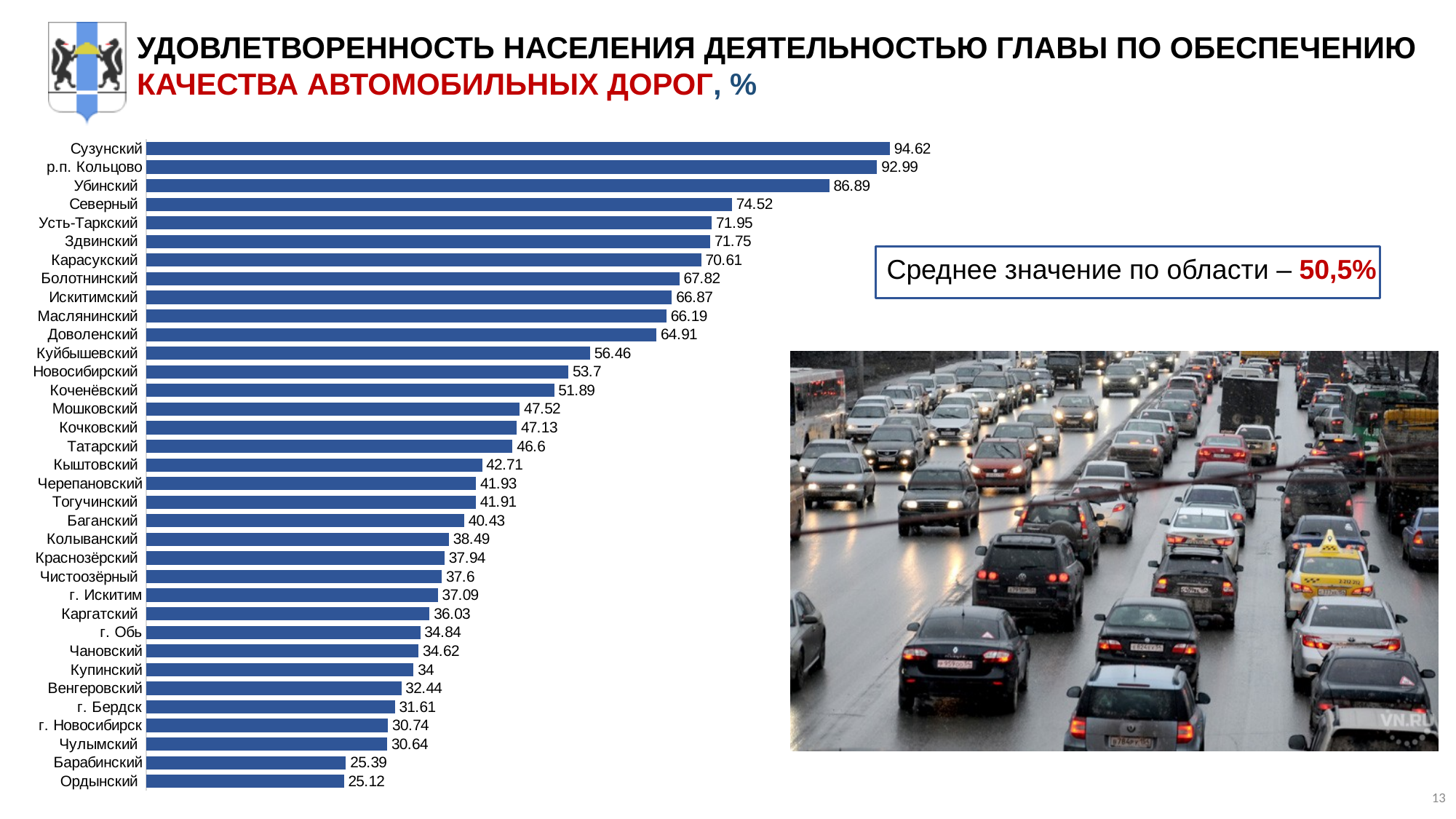
What is the value for Купинский? 34 What is the value for Куйбышевский? 56.46 Which category has the lowest value? Ордынский What is the value for Сузунский? 94.62 What is the regional average value stated on the slide? 50,5% How many categories are shown in the chart? 35 What is the difference between the values for Северный and Куйбышевский? 18.06 What kind of chart is shown on the slide? Bar chart What is the value for г. Новосибирск? 30.74 Which category has the highest value? Сузунский Which has a larger value, Убинский or Доволенский? Убинский What is the difference between the values for Сузунский and Ордынский? 69.5